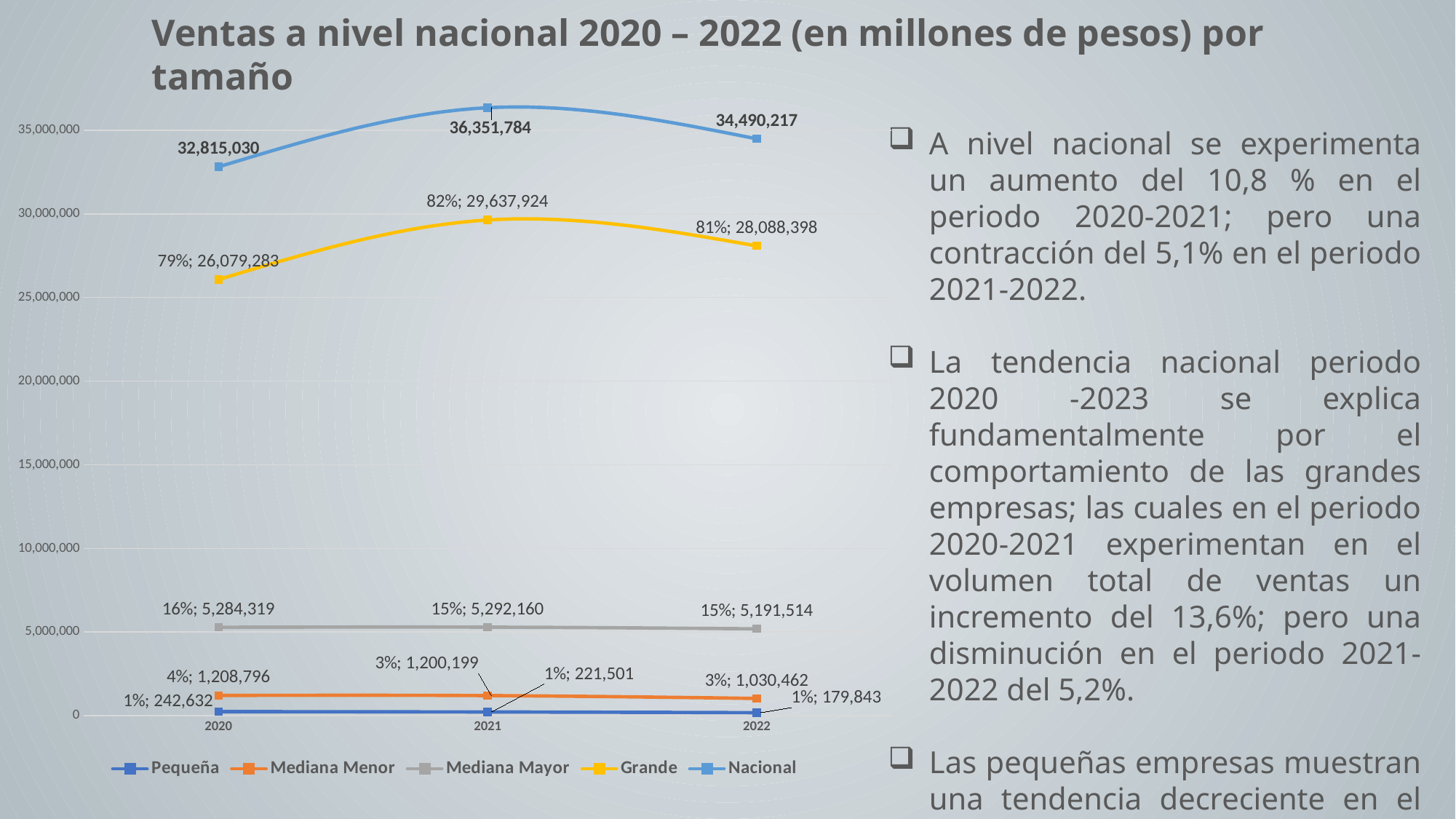
Which is larger, the Mediana Menor value for 2020 or for 2022? 2020 How many series does the legend list? 5 Is the Grande value for 2021 greater or less than 25,000,000? greater What percentage share is shown for Grande in 2021? 82% What is the Grande value for 2022? 28,088,398 How many years are plotted on the x axis? 3 In which year is the Pequeña value lowest? 2022 What type of chart is shown on the slide? line chart What is the difference between the Nacional values for 2021 and 2020? 3,536,754 What is the Mediana Mayor value for 2020? 5,284,319 What is the Nacional value for 2021? 36,351,784 In which year is the Nacional value highest? 2021